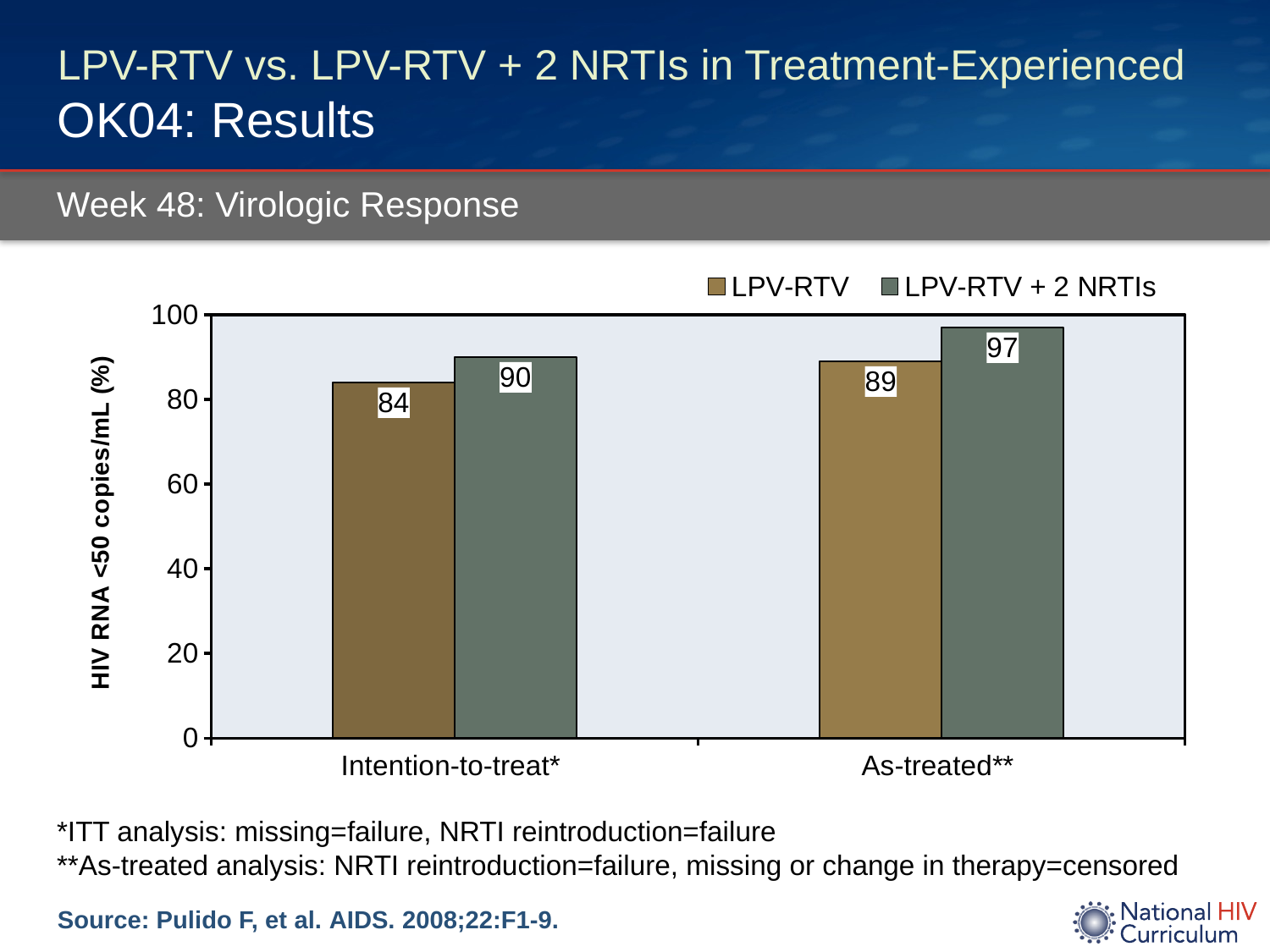
What is the value for LPV-RTV in the As-treated** category? 89 What is the value for LPV-RTV + 2 NRTIs in the Intention-to-treat* category? 90 Which is larger: LPV-RTV in As-treated** or LPV-RTV + 2 NRTIs in Intention-to-treat*? LPV-RTV + 2 NRTIs in Intention-to-treat* What is the difference between LPV-RTV + 2 NRTIs and LPV-RTV in the As-treated** category? 8 What is the value for LPV-RTV in the Intention-to-treat* category? 84 What kind of chart is shown on the slide? Bar chart Which bar has the lowest value on the chart? LPV-RTV, Intention-to-treat* Which bar has the highest value on the chart? LPV-RTV + 2 NRTIs, As-treated** What is the difference between LPV-RTV + 2 NRTIs and LPV-RTV in the Intention-to-treat* category? 6 How many series does the legend list? 2 What is the value for LPV-RTV + 2 NRTIs in the As-treated** category? 97 How many categories are shown on the x axis? 2